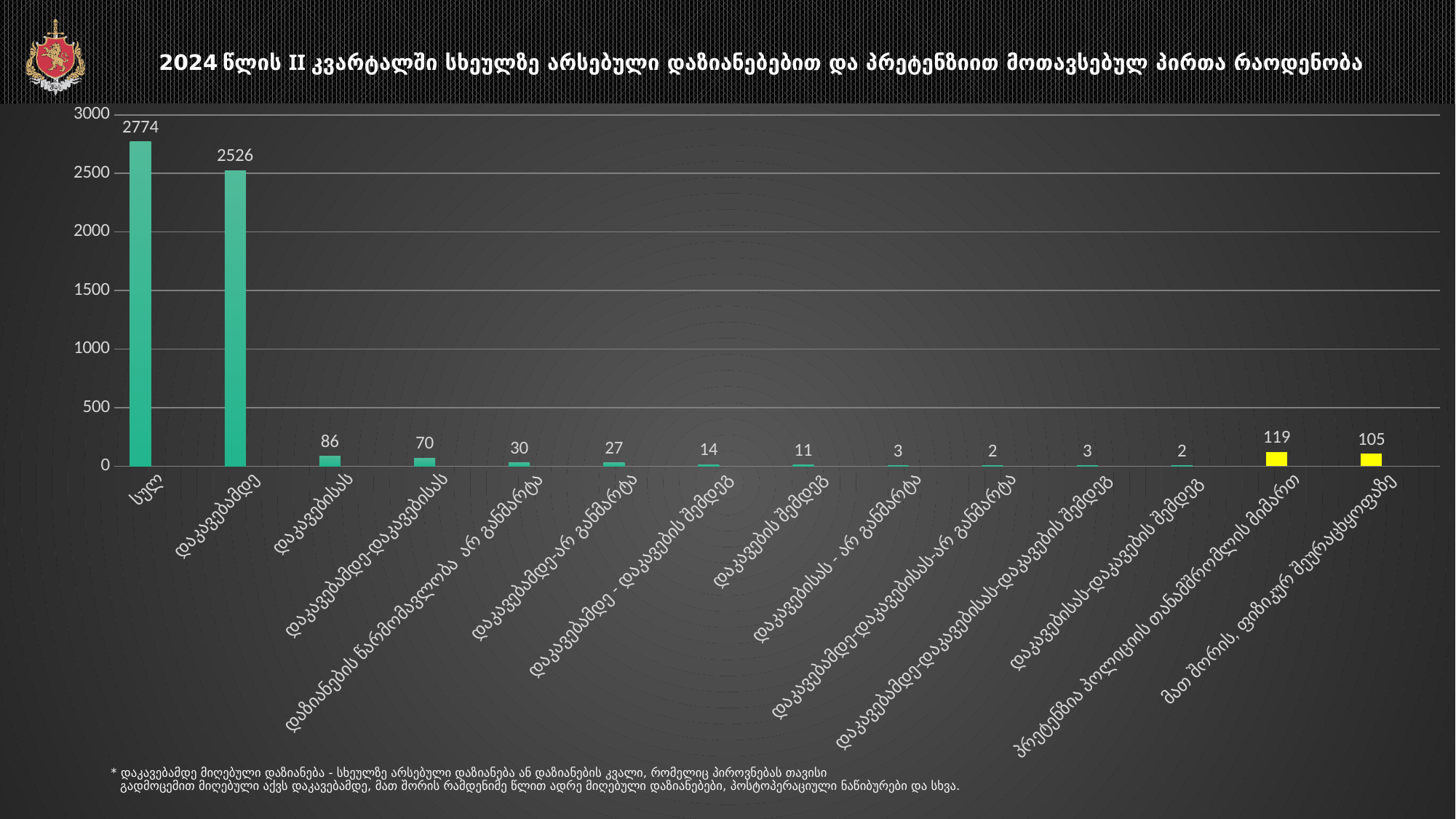
What is the difference between the values for პრეტენზია პოლიციის თანამშრომლის მიმართ and მათ შორის, ფიზიკურ შეურაცხყოფაზე? 14 How many categories are shown on the x axis? 14 Is the value for დაკავებამდე greater or less than 2000? greater What is the value for პრეტენზია პოლიციის თანამშრომლის მიმართ? 119 Which category has the highest value? სულ What is the value for დაკავებისას? 86 What kind of chart is shown on the slide? bar chart Which is larger, the value for დაკავებისას or the value for დაკავებამდე-დაკავებისას? დაკავებისას What is the value for სულ? 2774 What colour are the bars for the last two categories on the right? yellow What is the value for დაკავებამდე? 2526 What is the difference between the values for სულ and დაკავებამდე? 248